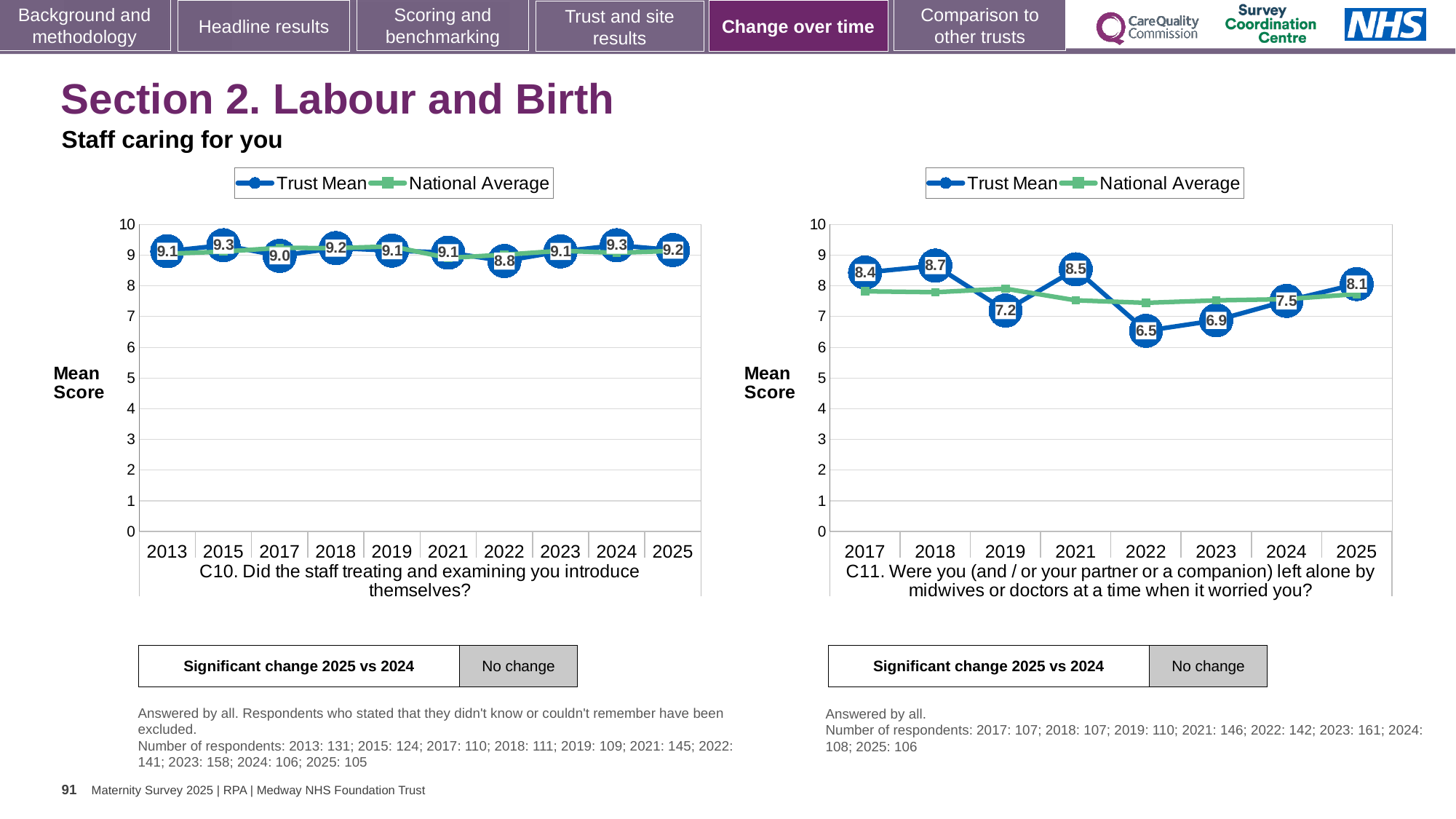
In the C11 chart (right), what is the Trust Mean for 2019? 7.2 In the C10 chart (left), how many years are shown on the x axis? 10 What kind of chart is the C10 chart (left)? Line chart In the C11 chart (right), which year has the lowest Trust Mean? 2022 In the C11 chart (right), is the Trust Mean for 2021 larger or smaller than the Trust Mean for 2023? larger How many series does the legend of the C11 chart (right) list? 2 In the C11 chart (right), which year has the highest Trust Mean? 2018 In the C10 chart (left), what is the Trust Mean for 2025? 9.2 In the C10 chart (left), what is the Trust Mean for 2022? 8.8 In the C11 chart (right), is the National Average for 2022 greater or less than 8? less In the C11 chart (right), what is the difference between the Trust Mean for 2025 and the Trust Mean for 2024? 0.6 In the C10 chart (left), which year has the lowest Trust Mean? 2022